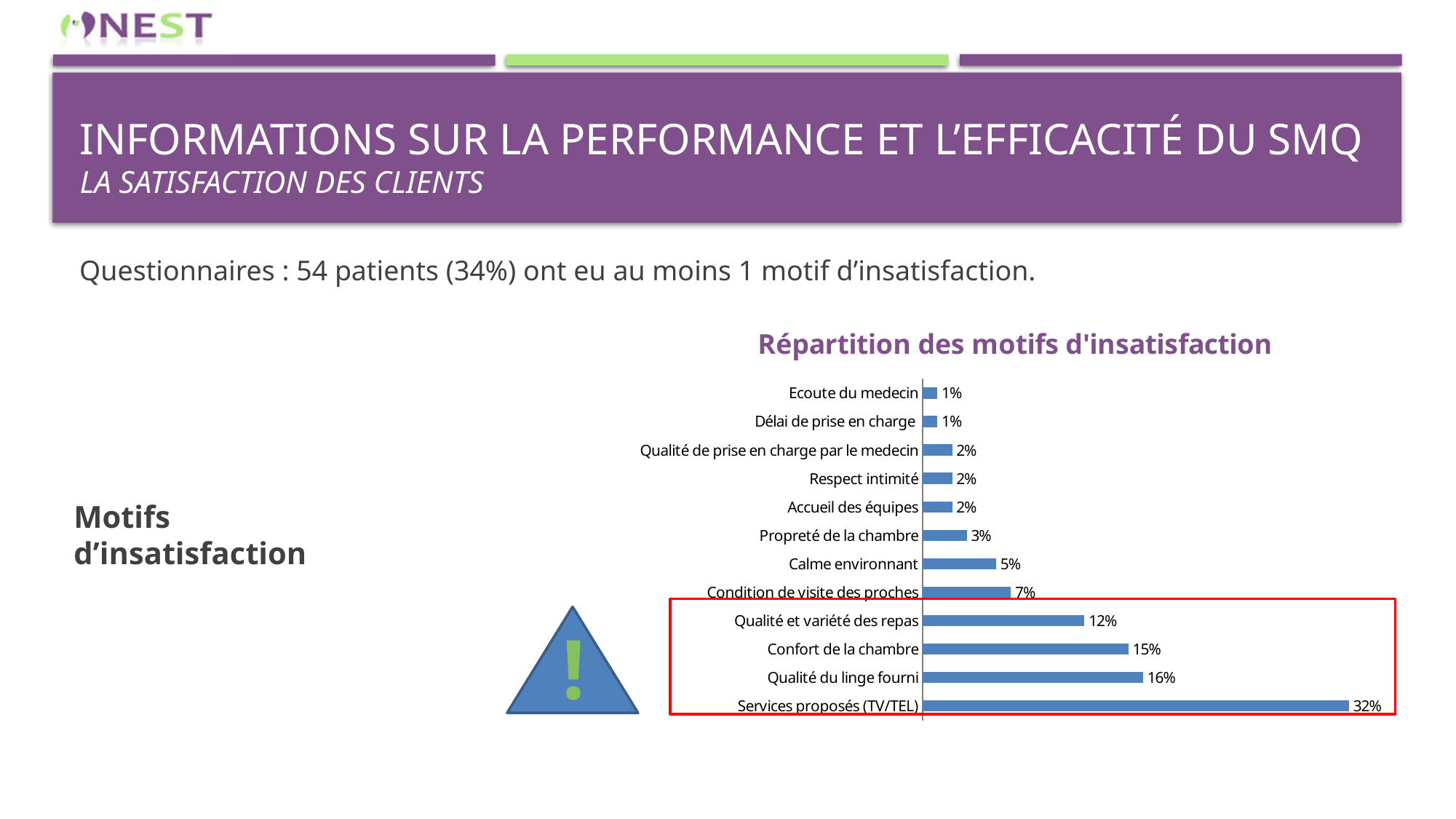
Which is larger, Qualité du linge fourni or Confort de la chambre? Qualité du linge fourni What is the value for Calme environnant? 5% What is the difference between Confort de la chambre and Condition de visite des proches? 8% What is the value for Qualité et variété des repas? 12% Which category has the highest value? Services proposés (TV/TEL) What is the difference between Services proposés (TV/TEL) and Qualité du linge fourni? 16% How many categories are shown in the chart? 12 What is the value for Services proposés (TV/TEL)? 32% What kind of chart is shown? Bar chart What is the title of the chart? Répartition des motifs d'insatisfaction What is the value for Propreté de la chambre? 3% Which is larger, Calme environnant or Condition de visite des proches? Condition de visite des proches